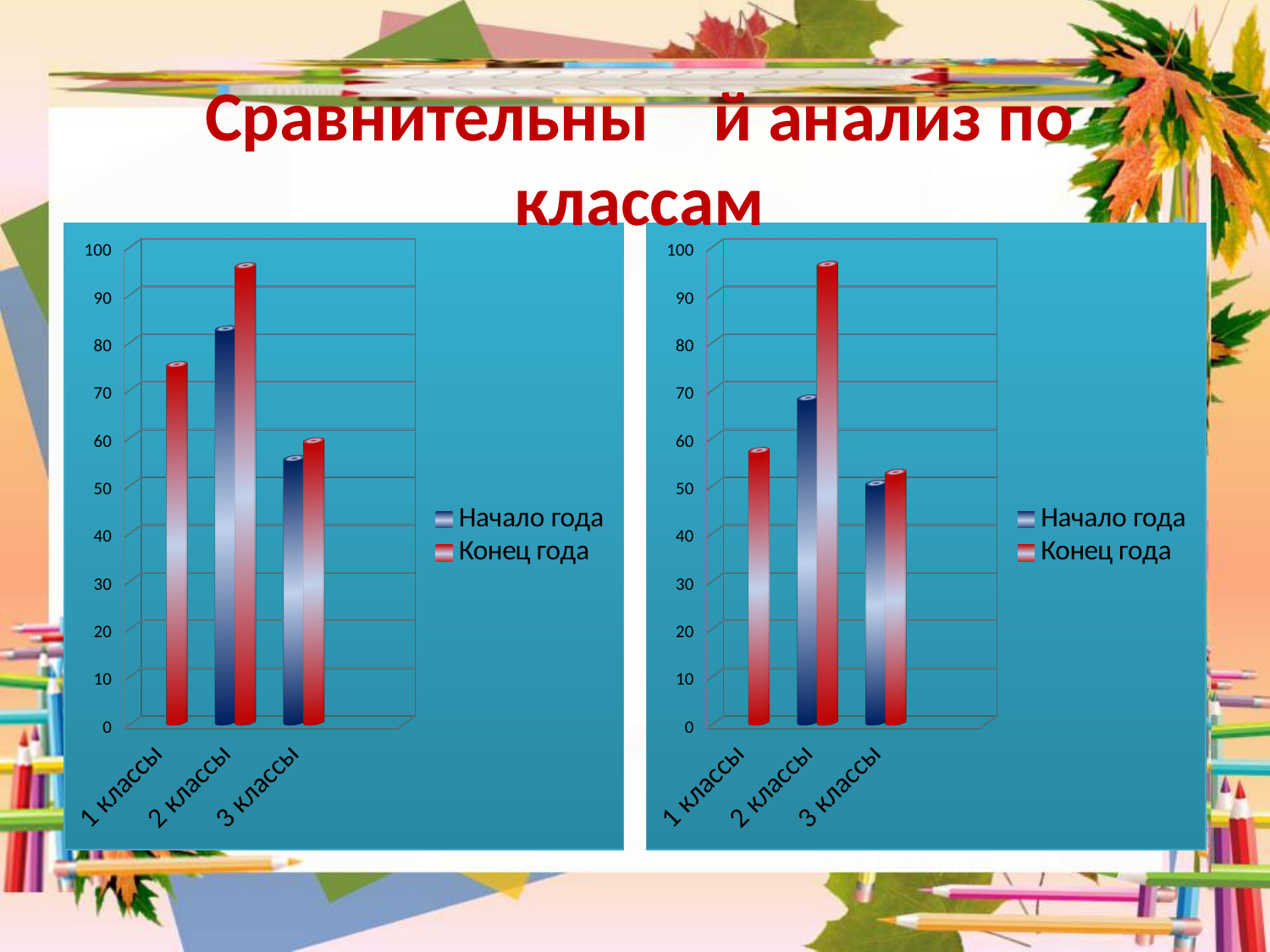
In the right chart, is the Конец года value for 1 классы greater or less than 50? greater In the right chart, for 2 классы, which is larger: Начало года or Конец года? Конец года In the right chart, is the Начало года value for 2 классы greater or less than 60? greater How many categories are shown on the x axis of the left chart? 3 In the left chart, is the Конец года value for 2 классы greater or less than 90? greater How many series does the legend of the right chart list? 2 In the left chart, which category has the highest Конец года bar? 2 классы What kind of chart is the left chart on the slide? bar chart What are the two legend entries in the left chart? Начало года, Конец года In the right chart, which category has the highest Конец года bar? 2 классы